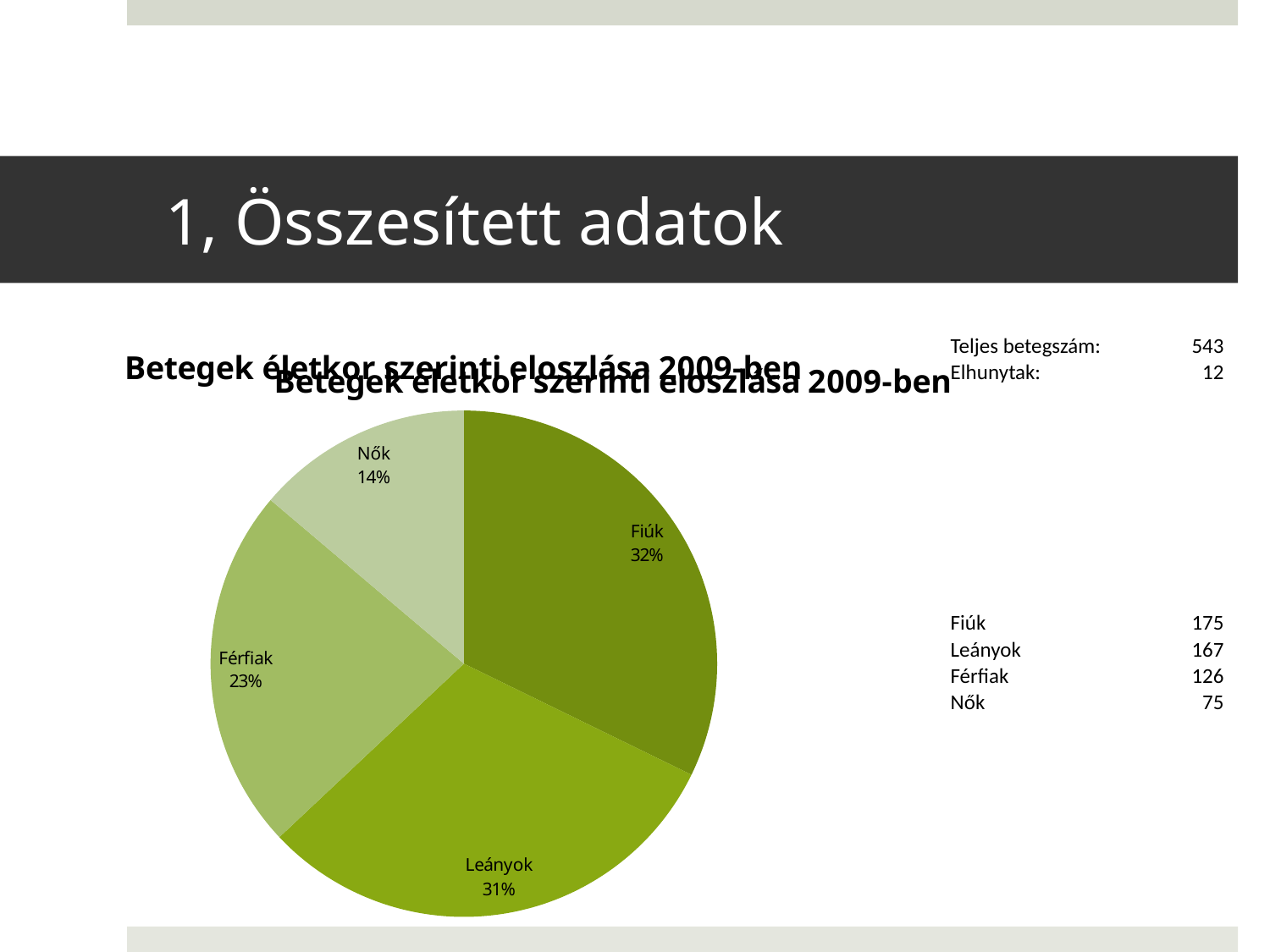
What share of the pie chart is the Fiúk slice? 32% What share of the pie chart is the Férfiak slice? 23% What is the difference in percentage points between the Leányok slice and the Férfiak slice? 8% Which slice is larger in the pie chart, Férfiak or Nők? Férfiak What share of the pie chart is the Nők slice? 14% What is the difference in percentage points between the Fiúk slice and the Nők slice? 18% Which slice of the pie chart is the largest? Fiúk What is the title of the pie chart? Betegek életkor szerinti eloszlása 2009-ben What kind of chart is shown on the slide? pie chart Which slice of the pie chart is the smallest? Nők How many slices does the pie chart have? 4